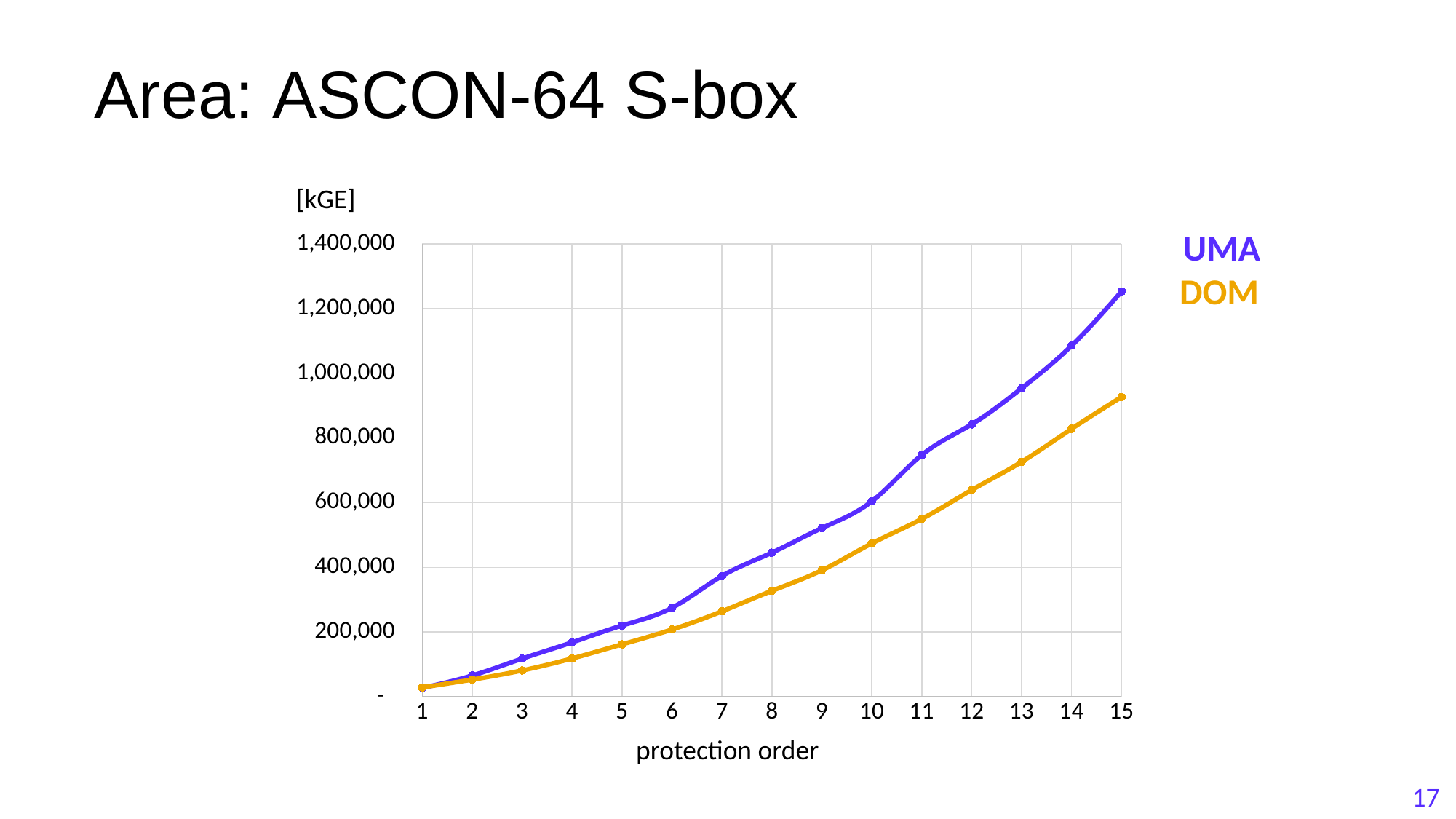
Is the UMA value at protection order 14 greater or less than 1,000,000? greater What is the label of the x axis? protection order At which protection order does the DOM series reach its highest value? 15 Is the UMA value at protection order 7 greater or less than 400,000? less At protection order 15, which series has the larger value, UMA or DOM? UMA How many series does the legend list? 2 What kind of chart is shown on the slide? line chart Is the DOM value at protection order 11 greater or less than 600,000? less Do the UMA values rise or fall as the protection order increases? rise At which protection order does the UMA series have its lowest value? 1 How many protection orders are plotted along the x axis? 15